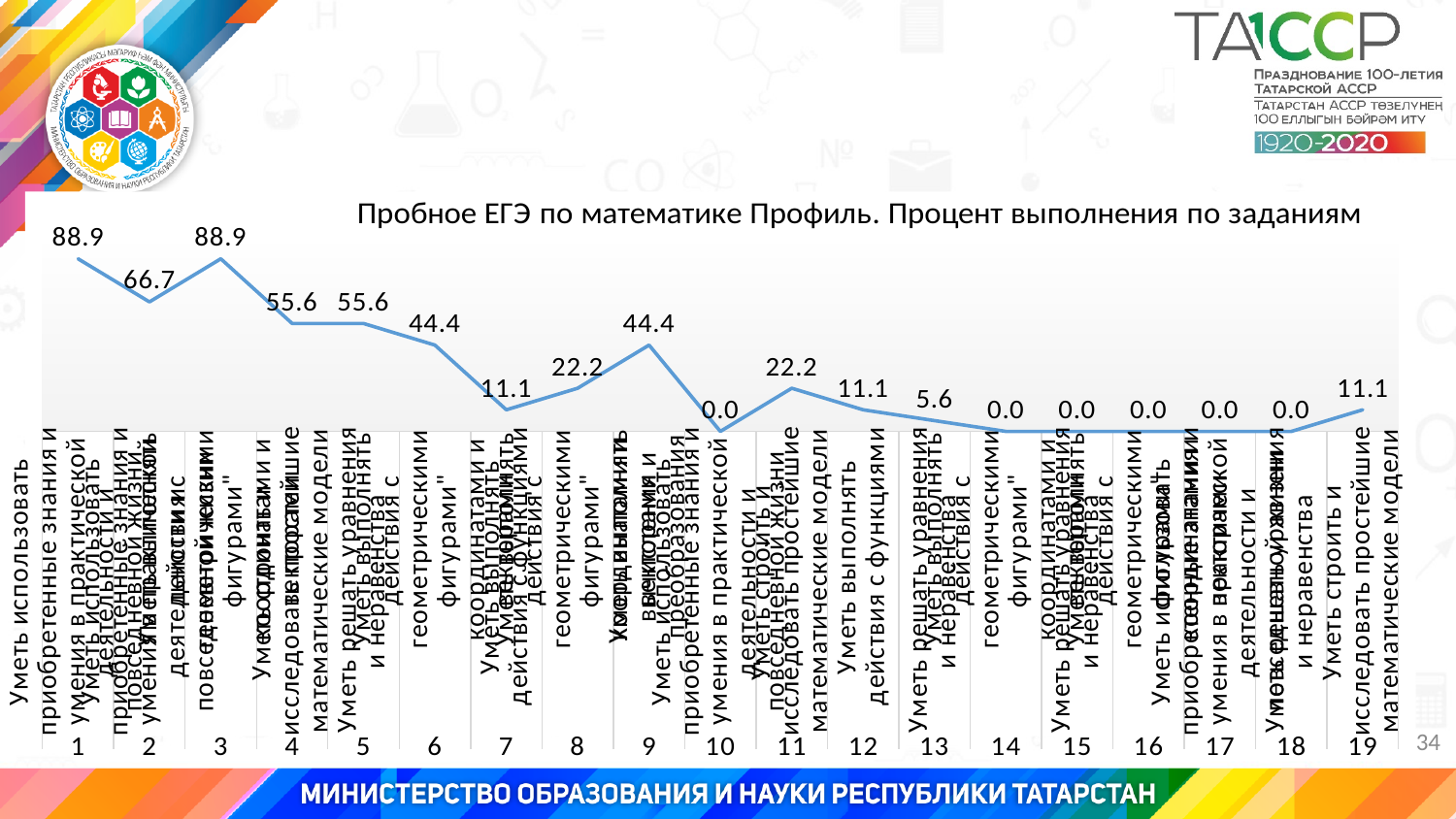
What is the highest value shown on the chart? 88.9 What is the value for task 2? 66.7 What is the difference between the values for task 1 and task 2? 22.2 What is the value for task 6? 44.4 Do the values generally rise or fall from task 1 to task 19? fall What is the value for task 13? 5.6 What is the value for task 19? 11.1 What is the title of the chart? Пробное ЕГЭ по математике Профиль. Процент выполнения по заданиям How many tasks are plotted on the x axis? 19 What type of chart is shown on the slide? line chart Which has a larger value, task 8 or task 9? task 9 What is the lowest value shown on the chart? 0.0